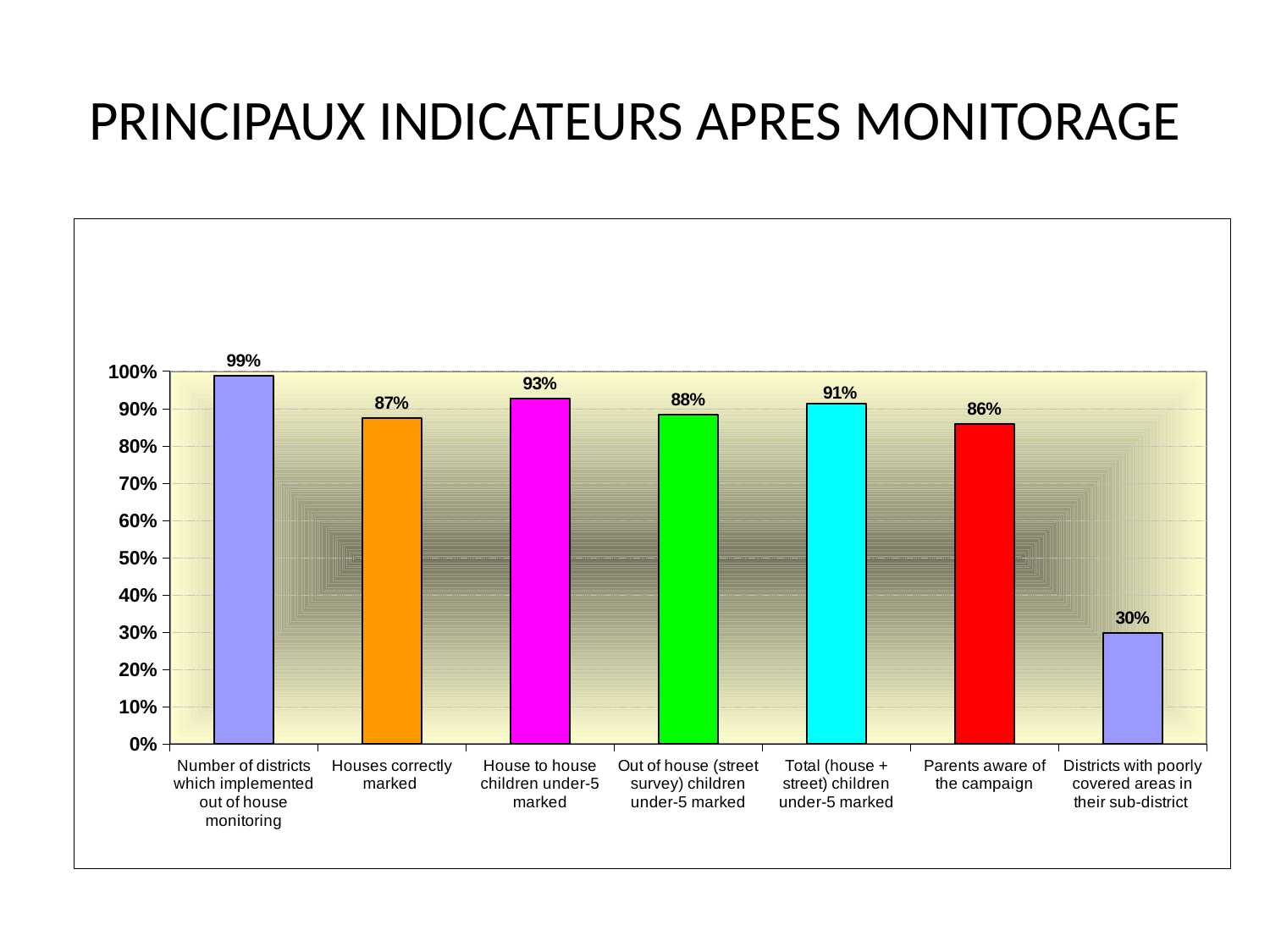
Which category has the highest value? Number of districts which implemented out of house monitoring What kind of chart is shown on the slide? Bar chart Is the value for "Districts with poorly covered areas in their sub-district" greater or less than 50%? less How many categories are shown in the chart? 7 Which category has the lowest value? Districts with poorly covered areas in their sub-district What is the title of the slide? PRINCIPAUX INDICATEURS APRES MONITORAGE What is the value for "Districts with poorly covered areas in their sub-district"? 30% What is the value for "Total (house + street) children under-5 marked"? 91% What is the difference between "House to house children under-5 marked" and "Out of house (street survey) children under-5 marked"? 5% What is the value for "Houses correctly marked"? 87% Which is larger: "House to house children under-5 marked" or "Total (house + street) children under-5 marked"? House to house children under-5 marked What is the value for "Parents aware of the campaign"? 86%